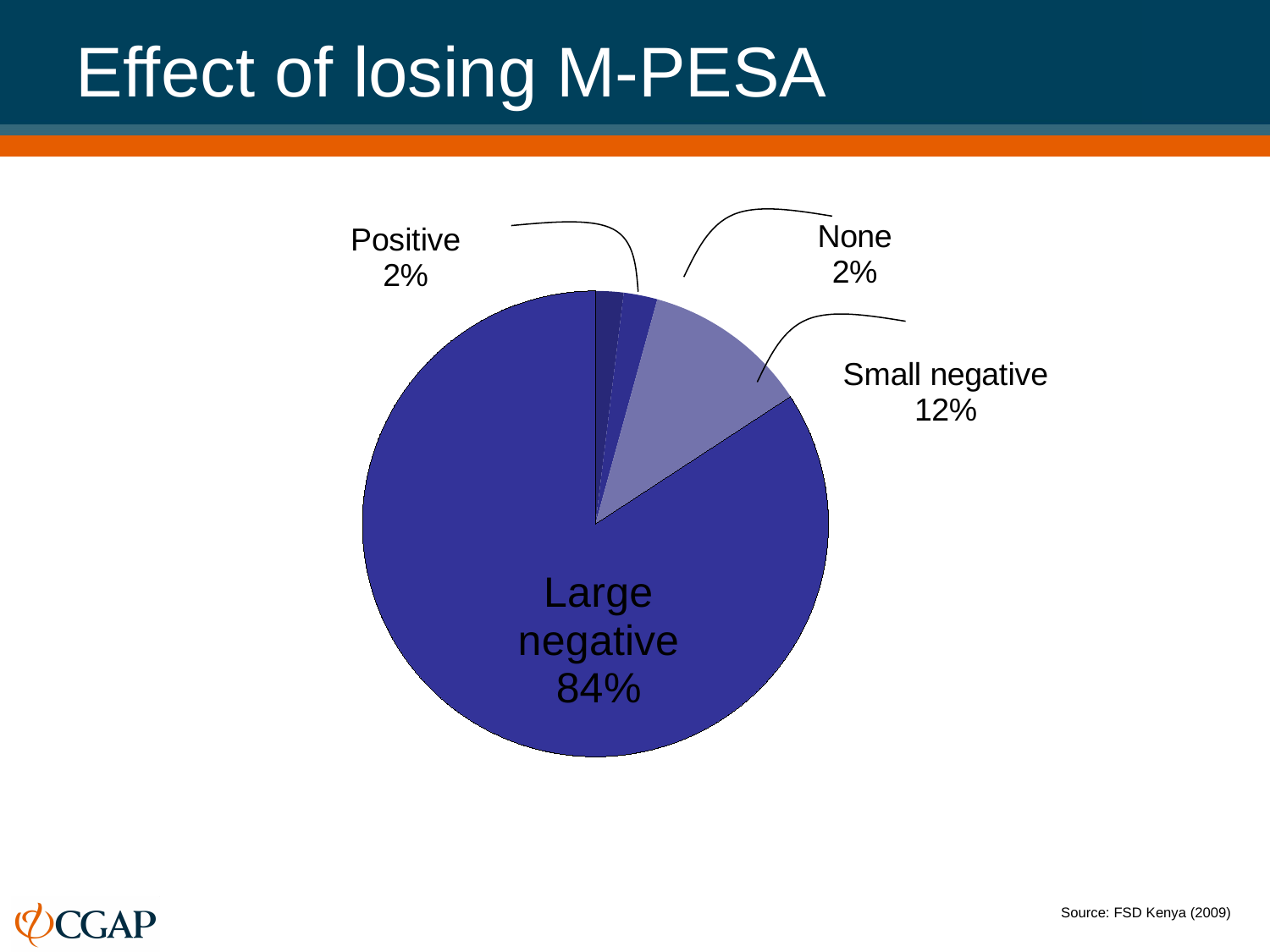
What share of the pie is labelled "Large negative"? 84% Which slice of the pie is the largest? Large negative What share of the pie is labelled "Positive"? 2% What share of the pie is labelled "None"? 2% What share of the pie is labelled "Small negative"? 12% What is the title of the slide containing the pie chart? Effect of losing M-PESA What kind of chart is shown on the slide? pie chart What is the difference in percentage points between the "Large negative" and "Small negative" slices? 72 Which slice is larger, "Small negative" or "Positive"? Small negative How many slices does the pie chart have? 4 What is the combined share of the "Positive" and "None" slices? 4% What source is cited for the chart data? FSD Kenya (2009)